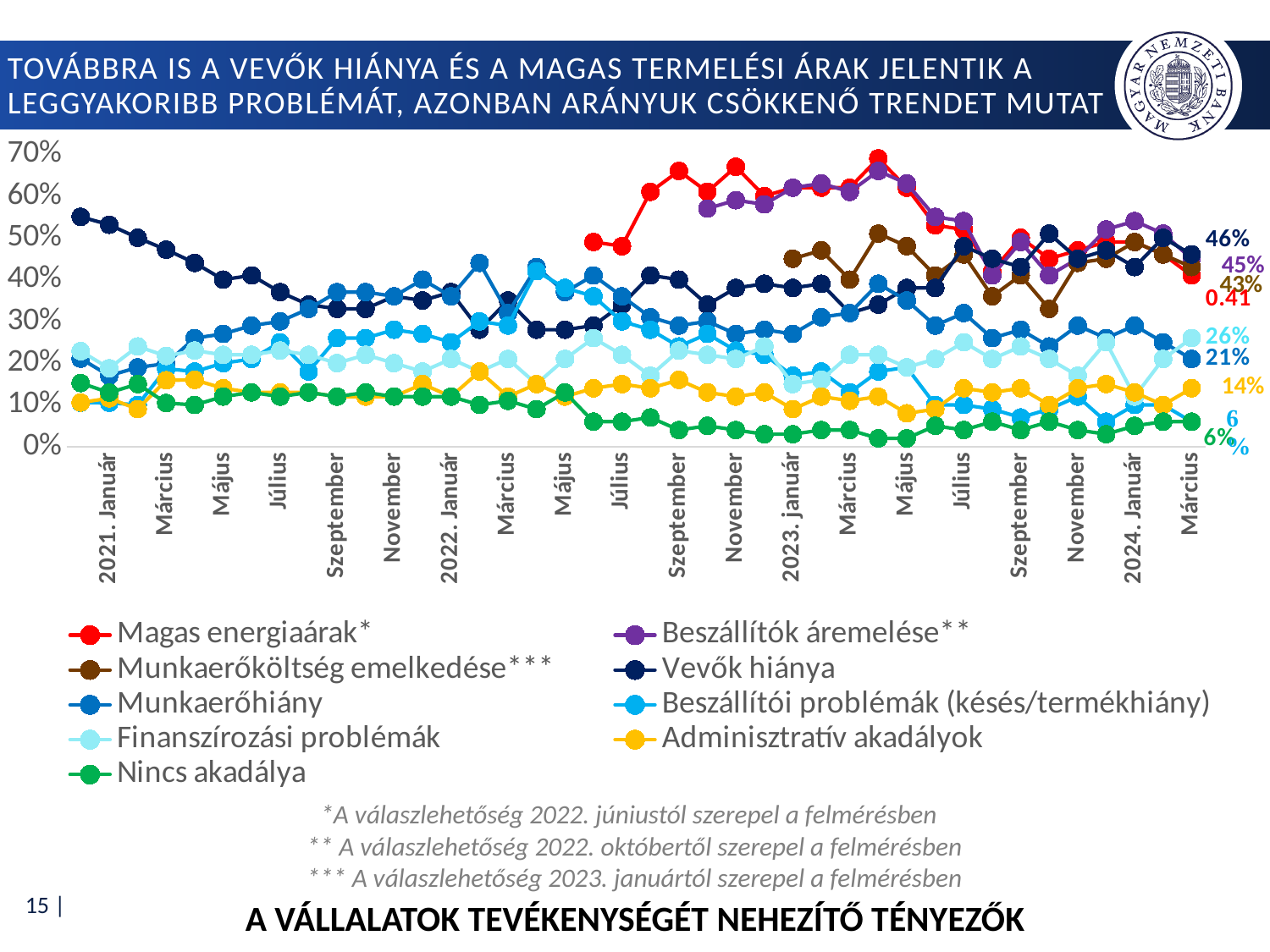
What is the value labelled at the end of the line for Munkaerőhiány? 21% How many series does the legend list? 9 What is the value labelled at the end of the line for Beszállítók áremelése? 45% Is the value for Vevők hiánya in 2021 January greater or less than 50%? greater Which series has the highest labelled value at the last data point (2024 March)? Vevők hiánya What is the difference between the final labelled values of Vevők hiánya (46%) and Munkaerőhiány (21%)? 25 percentage points What is the value labelled at the end of the line for Vevők hiánya? 46% What is the value labelled at the end of the line for Adminisztratív akadályok? 14% What kind of chart is shown on the slide? line chart Does the Vevők hiánya line rise or fall between 2021 January and 2021 September? fall What is the value labelled at the end of the line for Munkaerőköltség emelkedése? 43%